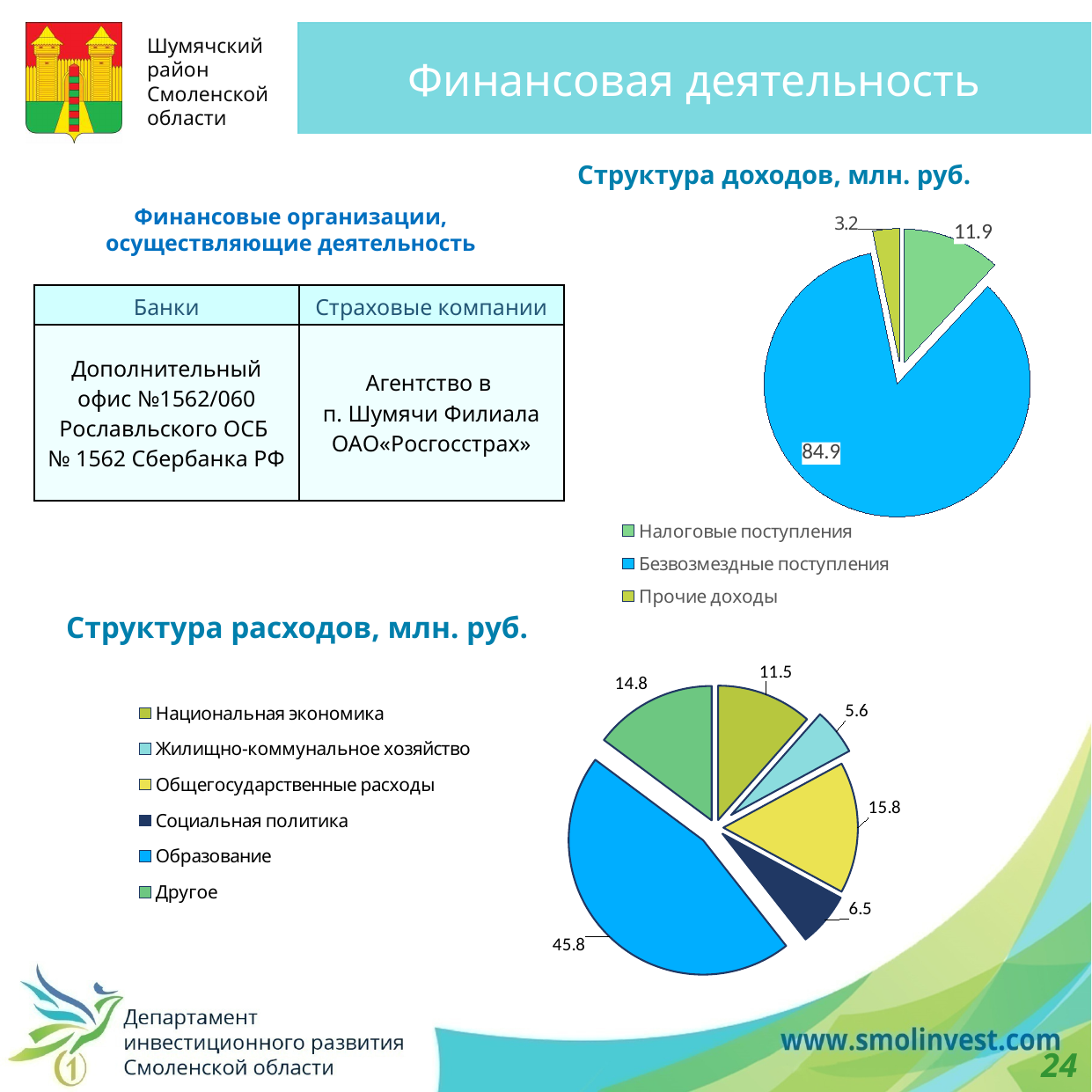
In the 'Структура расходов, млн. руб.' pie chart, which is larger: Общегосударственные расходы or Другое? Общегосударственные расходы How many categories does the legend of the 'Структура доходов, млн. руб.' chart list? 3 How many categories are shown in the 'Структура расходов, млн. руб.' pie chart? 6 In the 'Структура доходов, млн. руб.' pie chart, which category has the largest value? Безвозмездные поступления In the 'Структура доходов, млн. руб.' pie chart, what is the difference between Налоговые поступления and Прочие доходы? 8.7 In the 'Структура расходов, млн. руб.' pie chart, what is the difference between Образование and Социальная политика? 39.3 In the 'Структура расходов, млн. руб.' pie chart, which category has the smallest value? Жилищно-коммунальное хозяйство In the 'Структура расходов, млн. руб.' pie chart, what is the value for Образование? 45.8 In the 'Структура доходов, млн. руб.' pie chart, what is the value for Прочие доходы? 3.2 In the 'Структура расходов, млн. руб.' pie chart, what is the value for Жилищно-коммунальное хозяйство? 5.6 What type of chart is used for 'Структура расходов, млн. руб.'? Pie chart In the 'Структура доходов, млн. руб.' pie chart, what is the value for Безвозмездные поступления? 84.9